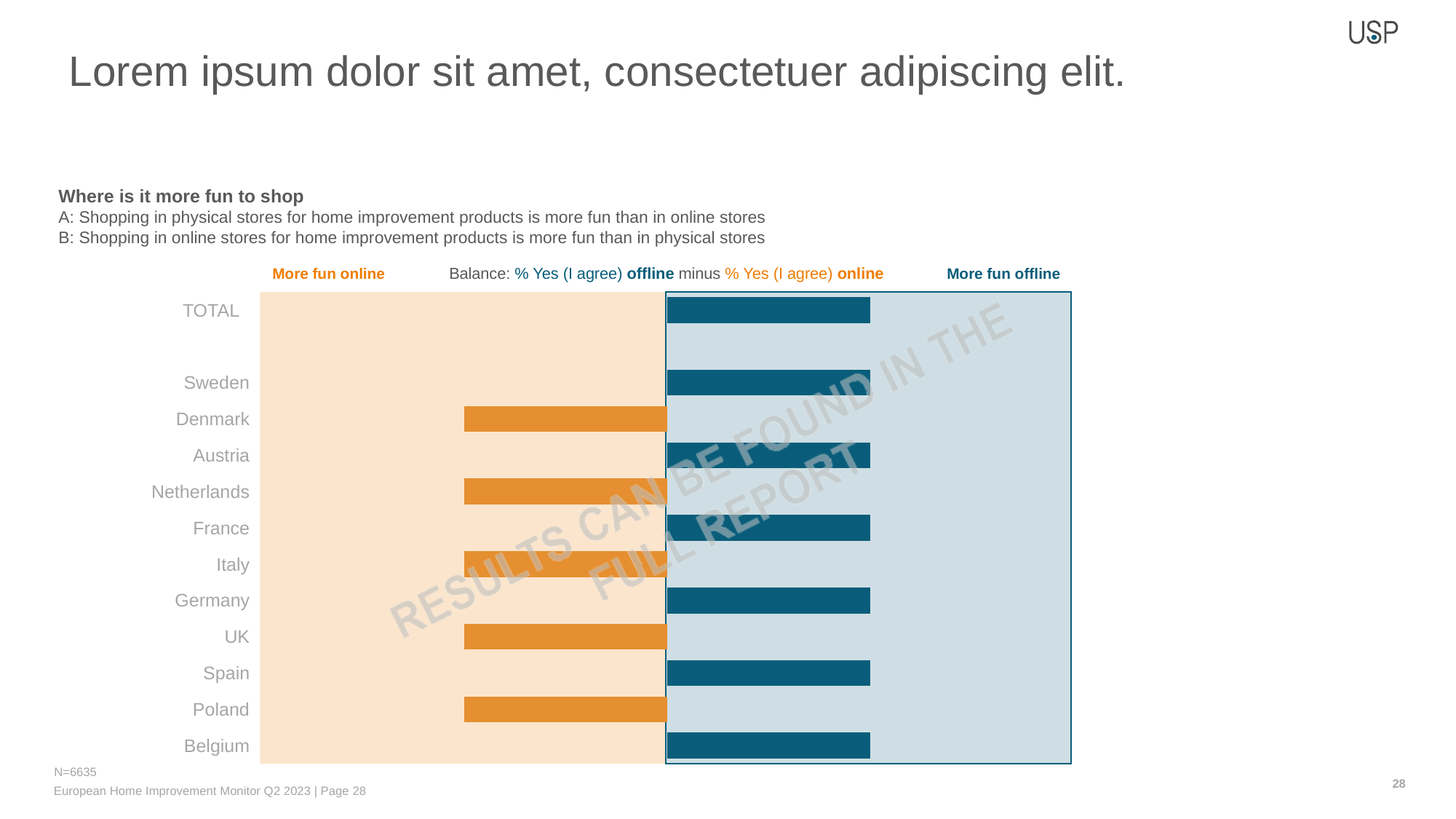
Does the bar for Poland point toward 'More fun online' or 'More fun offline'? More fun online Which side of the chart is labelled 'More fun online'? Left How many categories (including TOTAL) are listed on the chart? 12 What is the title of the chart? Where is it more fun to shop Does the bar for Denmark point toward 'More fun online' or 'More fun offline'? More fun online What kind of chart is shown on the slide? Bar chart How many categories have bars pointing toward 'More fun offline'? 7 Does the bar for Sweden point toward 'More fun online' or 'More fun offline'? More fun offline How many countries, excluding TOTAL, are listed on the chart? 11 Does the bar for TOTAL point toward 'More fun online' or 'More fun offline'? More fun offline